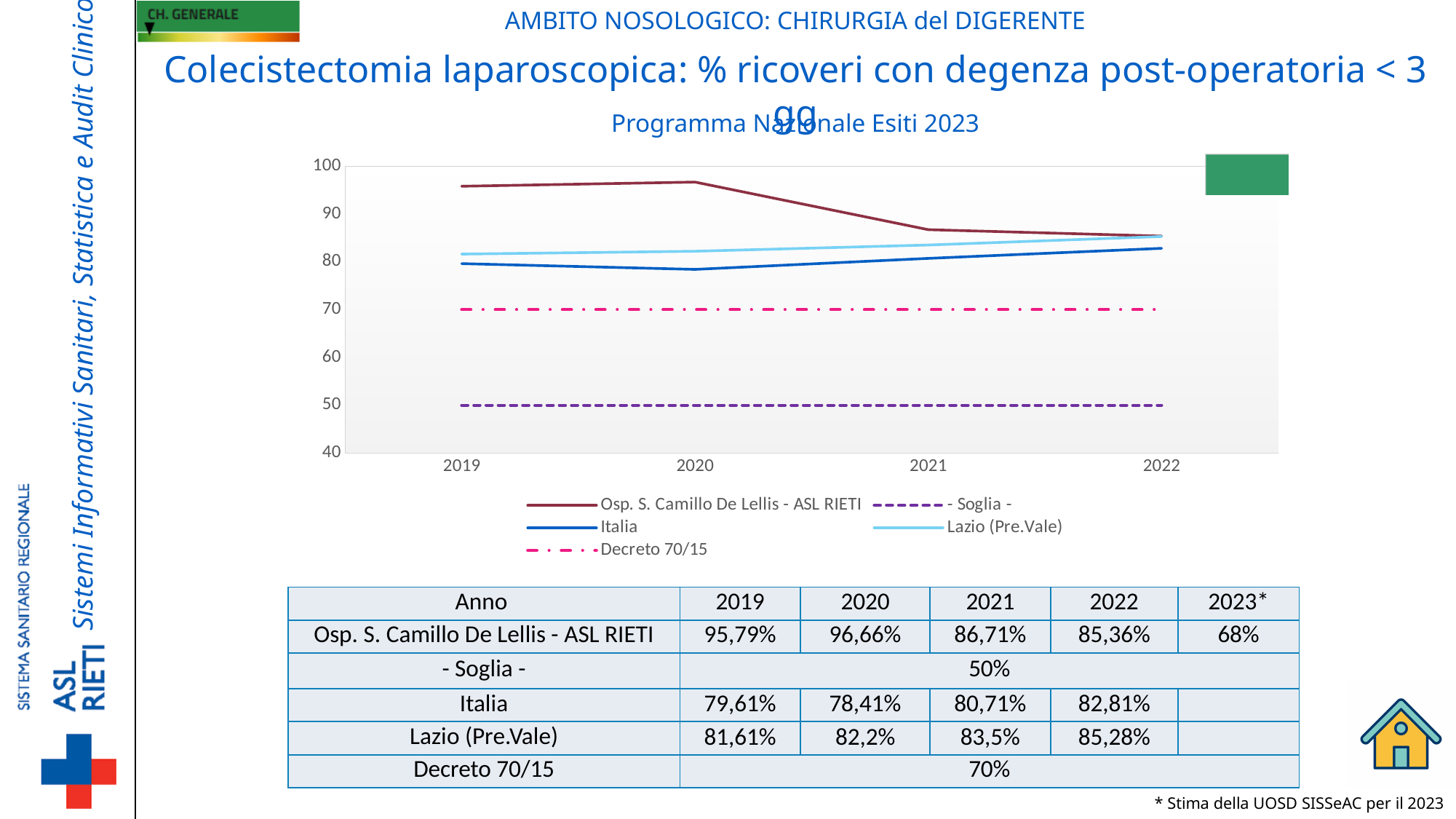
What is the value of the - Soglia - line? 50% In 2021, which is higher: Osp. S. Camillo De Lellis - ASL RIETI or Lazio (Pre.Vale)? Osp. S. Camillo De Lellis - ASL RIETI In which year is the value for Osp. S. Camillo De Lellis - ASL RIETI highest? 2020 What is the value for Italia in 2022? 82,81% How many years are shown on the x axis of the chart? 4 Is the value of the Decreto 70/15 line greater or less than 60? greater What is the difference between the Lazio (Pre.Vale) values for 2022 and 2019? 3,67% In which year is the value for Italia lowest? 2020 Does the Lazio (Pre.Vale) line rise or fall from 2019 to 2022? rises How many series does the chart legend list? 5 What kind of chart is shown on the slide? line chart What is the value for Osp. S. Camillo De Lellis - ASL RIETI in 2019? 95,79%